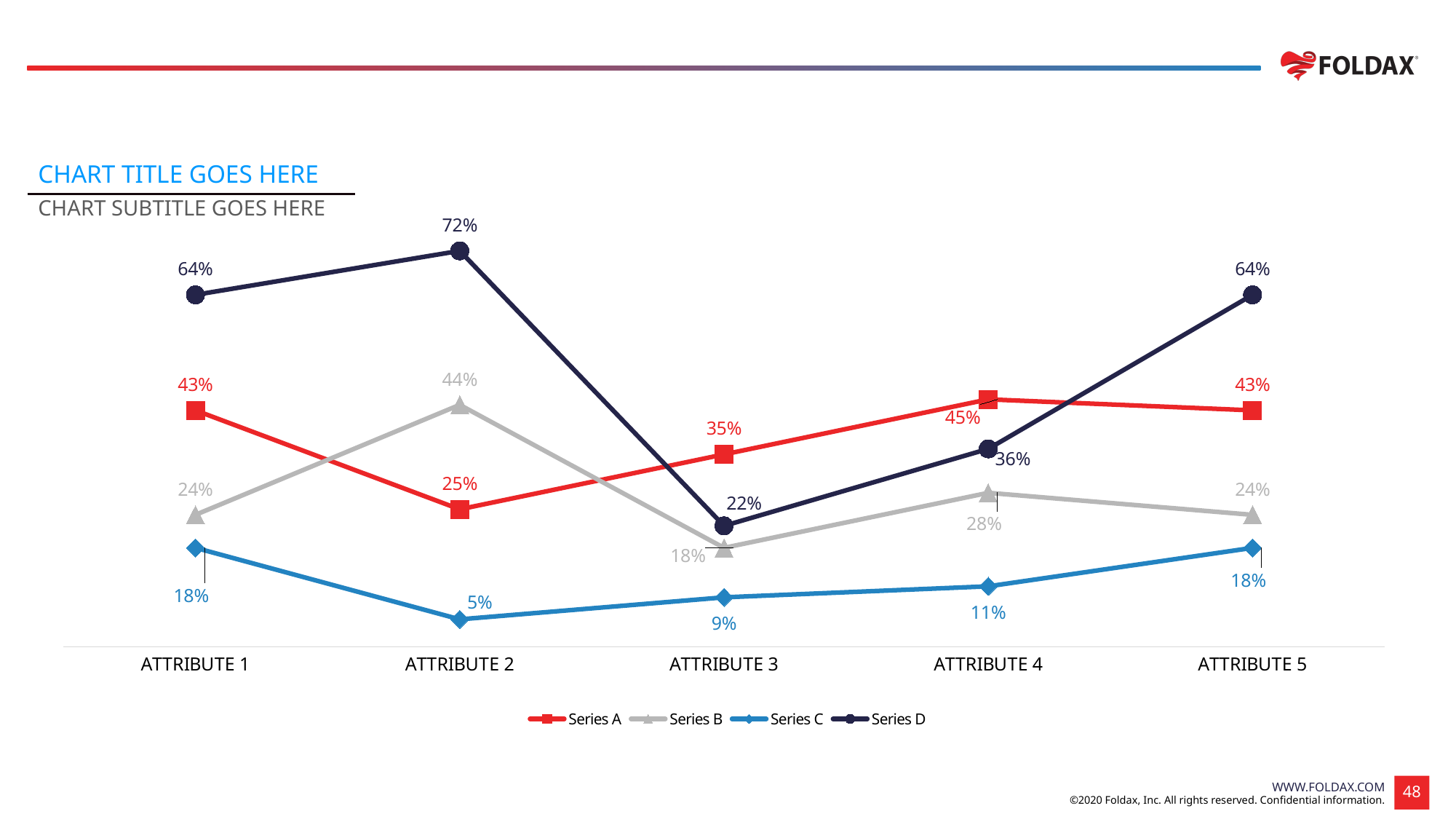
At which attribute does Series D reach its highest value? Attribute 2 What is the difference between Series D and Series A at Attribute 1? 21% What is the title of the chart? CHART TITLE GOES HERE At which attribute does Series A have its lowest value? Attribute 2 What is the value for Series D at Attribute 2? 72% What is the value for Series B at Attribute 4? 28% What is the value for Series C at Attribute 2? 5% What kind of chart is shown on the slide? Line chart How many categories are shown on the x axis? 5 Which is larger at Attribute 3: Series A or Series D? Series A How many series does the legend list? 4 Does Series C rise or fall from Attribute 2 to Attribute 5? Rise